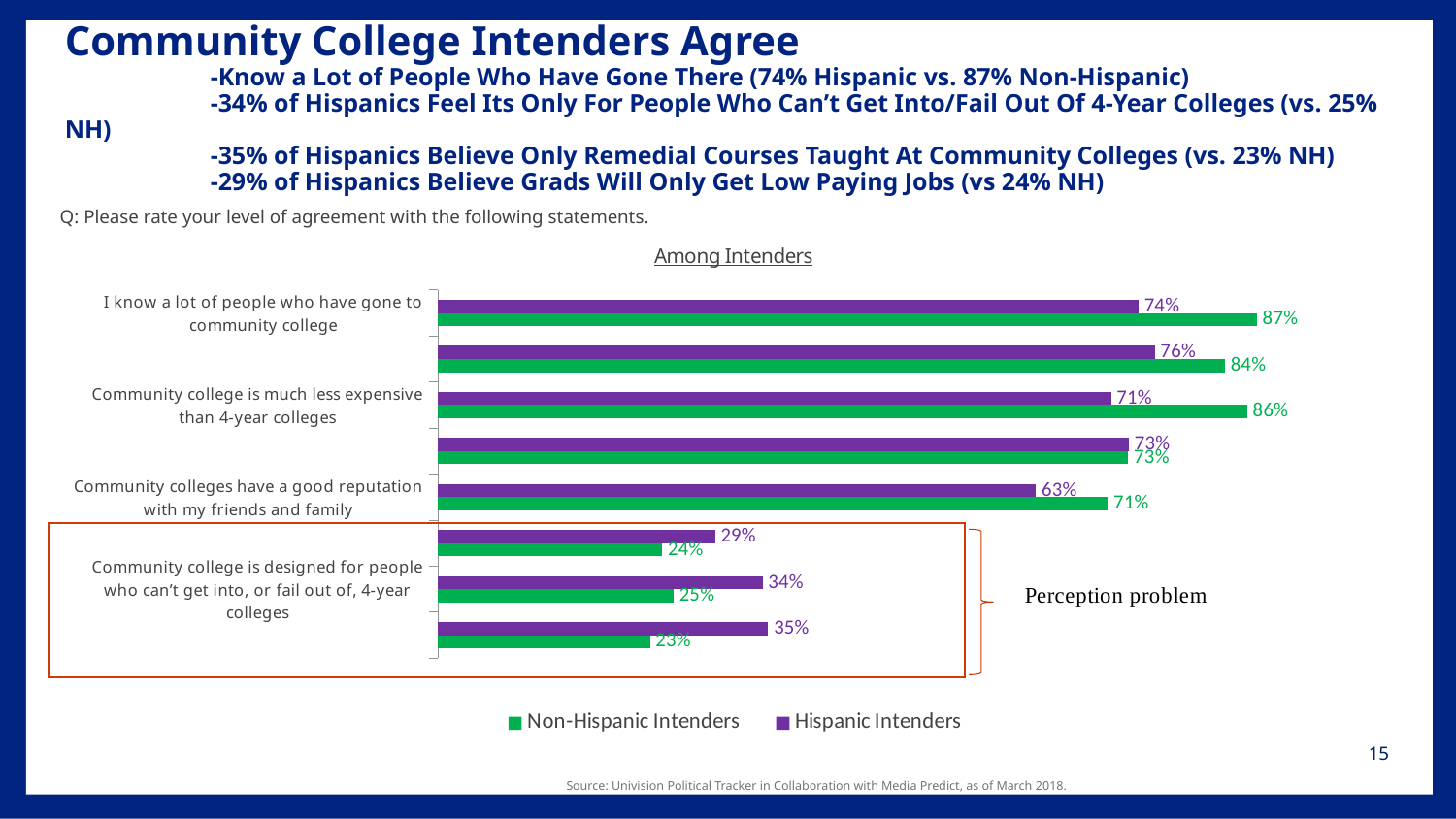
On "Community college is designed for people who can't get into, or fail out of, 4-year colleges", which group has the larger value, Hispanic Intenders or Non-Hispanic Intenders? Hispanic Intenders What is the value for Hispanic Intenders on "Community college is designed for people who can't get into, or fail out of, 4-year colleges"? 34% What is the value for Non-Hispanic Intenders on "Community college is much less expensive than 4-year colleges"? 86% What is the difference between Non-Hispanic Intenders and Hispanic Intenders on "Community college is much less expensive than 4-year colleges"? 15% What is the value for Hispanic Intenders on "I know a lot of people who have gone to community college"? 74% What is the difference between Non-Hispanic Intenders and Hispanic Intenders on "I know a lot of people who have gone to community college"? 13% What is the value for Non-Hispanic Intenders on "I know a lot of people who have gone to community college"? 87% What kind of chart is shown on the slide? Bar chart What is the value for Hispanic Intenders on "Community colleges have a good reputation with my friends and family"? 63% On "Community colleges have a good reputation with my friends and family", which group has the larger value, Hispanic Intenders or Non-Hispanic Intenders? Non-Hispanic Intenders How many series does the legend list? 2 Which colour represents Hispanic Intenders in the chart? Purple